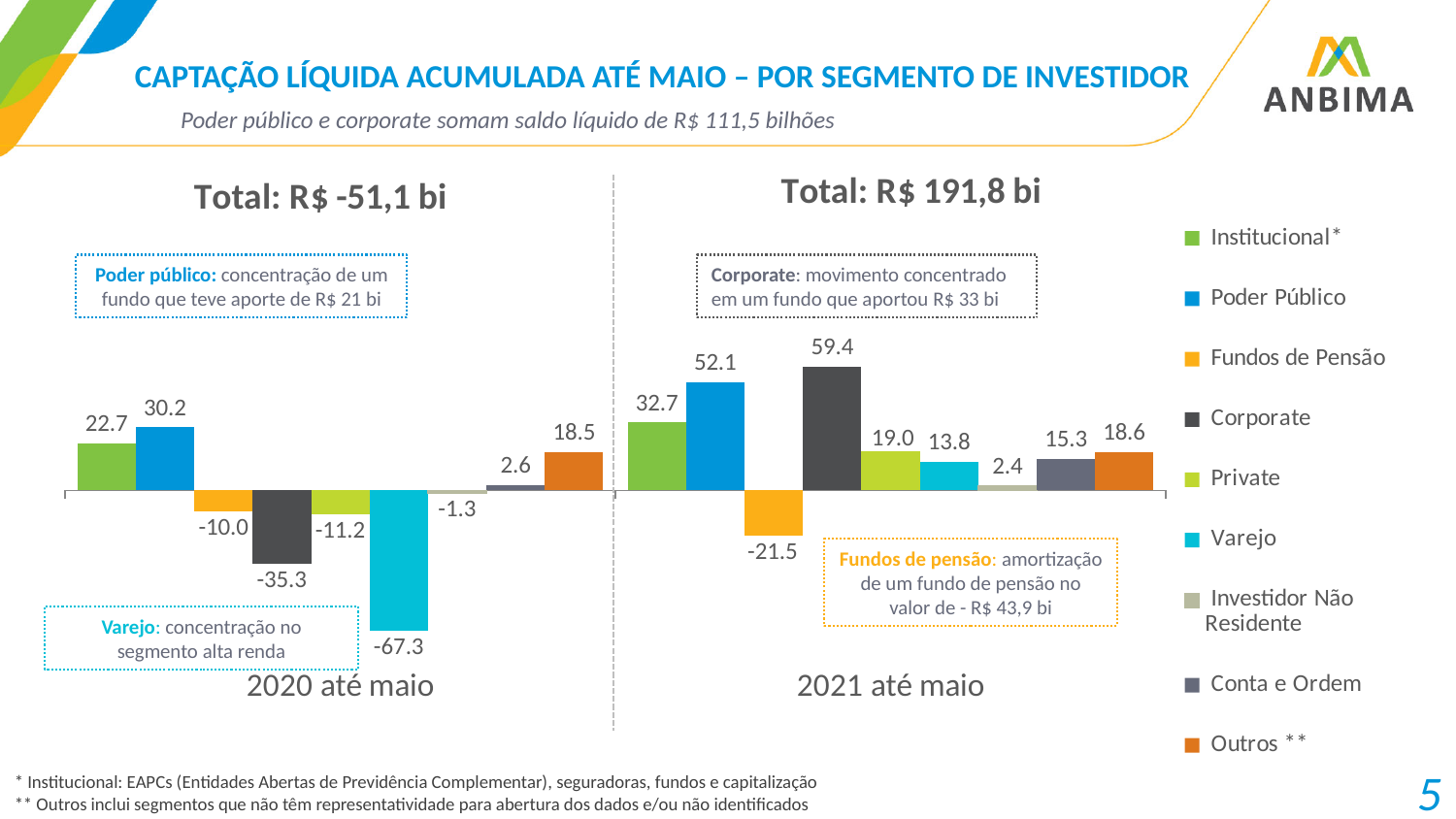
What total is shown above the 2021 até maio group? Total: R$ 191,8 bi Which is larger: Institucional in 2020 até maio or Institucional in 2021 até maio? Institucional in 2021 até maio What is the value for Varejo in 2020 até maio? -67.3 What kind of chart is shown on the slide? Bar chart What is the value for Poder Público in 2020 até maio? 30.2 How many period groups are shown on the x axis? 2 How many series does the legend list? 9 What is the value for Corporate in 2021 até maio? 59.4 What is the value for Fundos de Pensão in 2021 até maio? -21.5 Which series has the highest value in 2021 até maio? Corporate Which series has the lowest value in 2020 até maio? Varejo What is the difference between the Poder Público values for 2021 até maio and 2020 até maio? 21.9